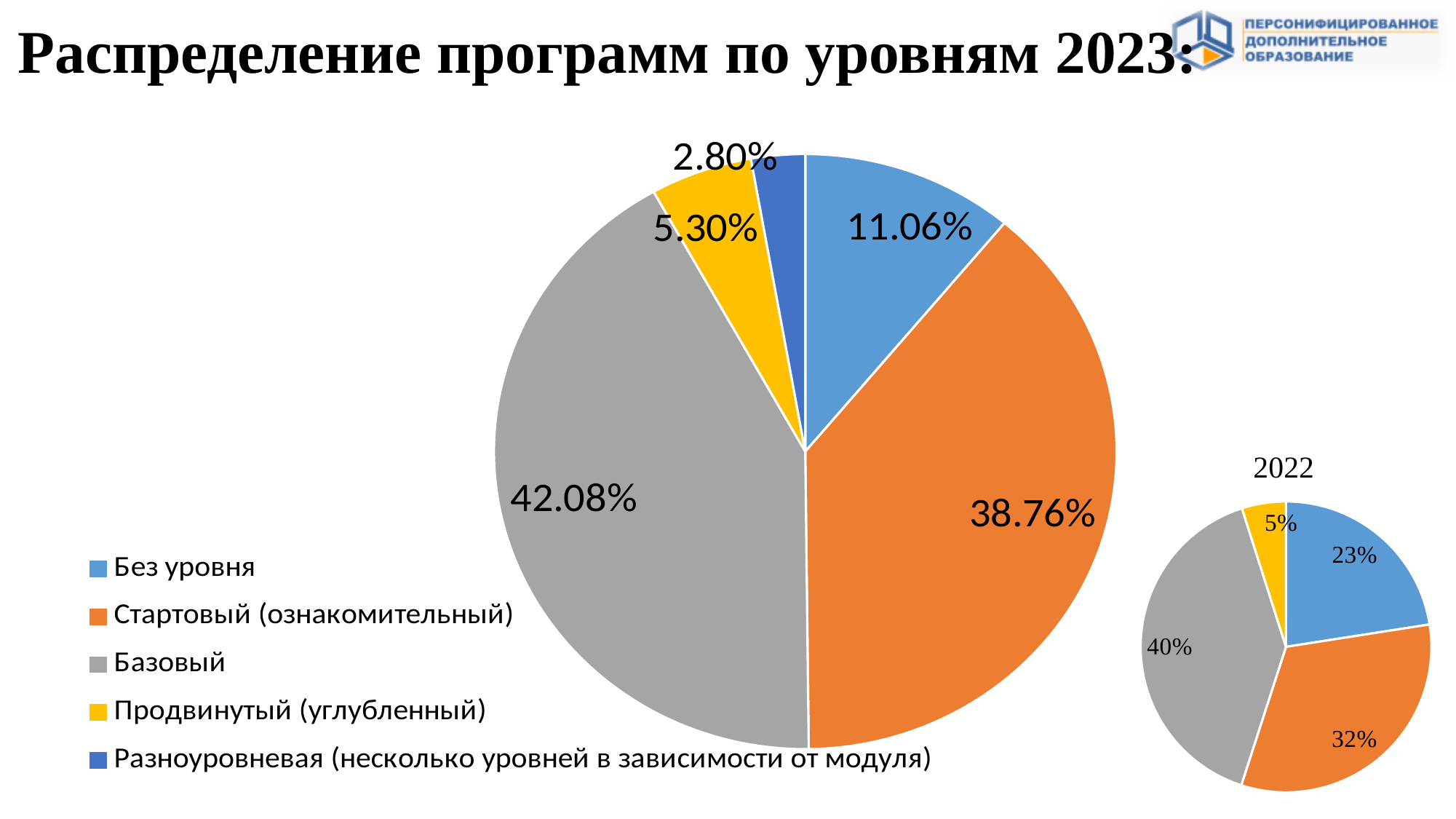
How many categories does the legend of the large 2023 pie chart list? 5 In the large 2023 pie chart, which category has the smallest share? Разноуровневая (несколько уровней в зависимости от модуля) In the small 2022 pie chart, what share is shown for the blue slice? 23% In the small 2022 pie chart, what share is shown for the gray slice? 40% In the large 2023 pie chart, what is the difference between the shares of Базовый and Стартовый (ознакомительный)? 3.32% In the small 2022 pie chart, what is the difference between the orange slice and the yellow slice? 27% What type of chart is used on this slide? Pie chart In the large 2023 pie chart, which category has the largest share? Базовый In the large 2023 pie chart, what share is shown for Базовый? 42.08% In the large 2023 pie chart, what share is shown for Разноуровневая (несколько уровней в зависимости от модуля)? 2.80% In the large 2023 pie chart, what share is shown for Стартовый (ознакомительный)? 38.76% In the large 2023 pie chart, which is larger: Без уровня or Продвинутый (углубленный)? Без уровня